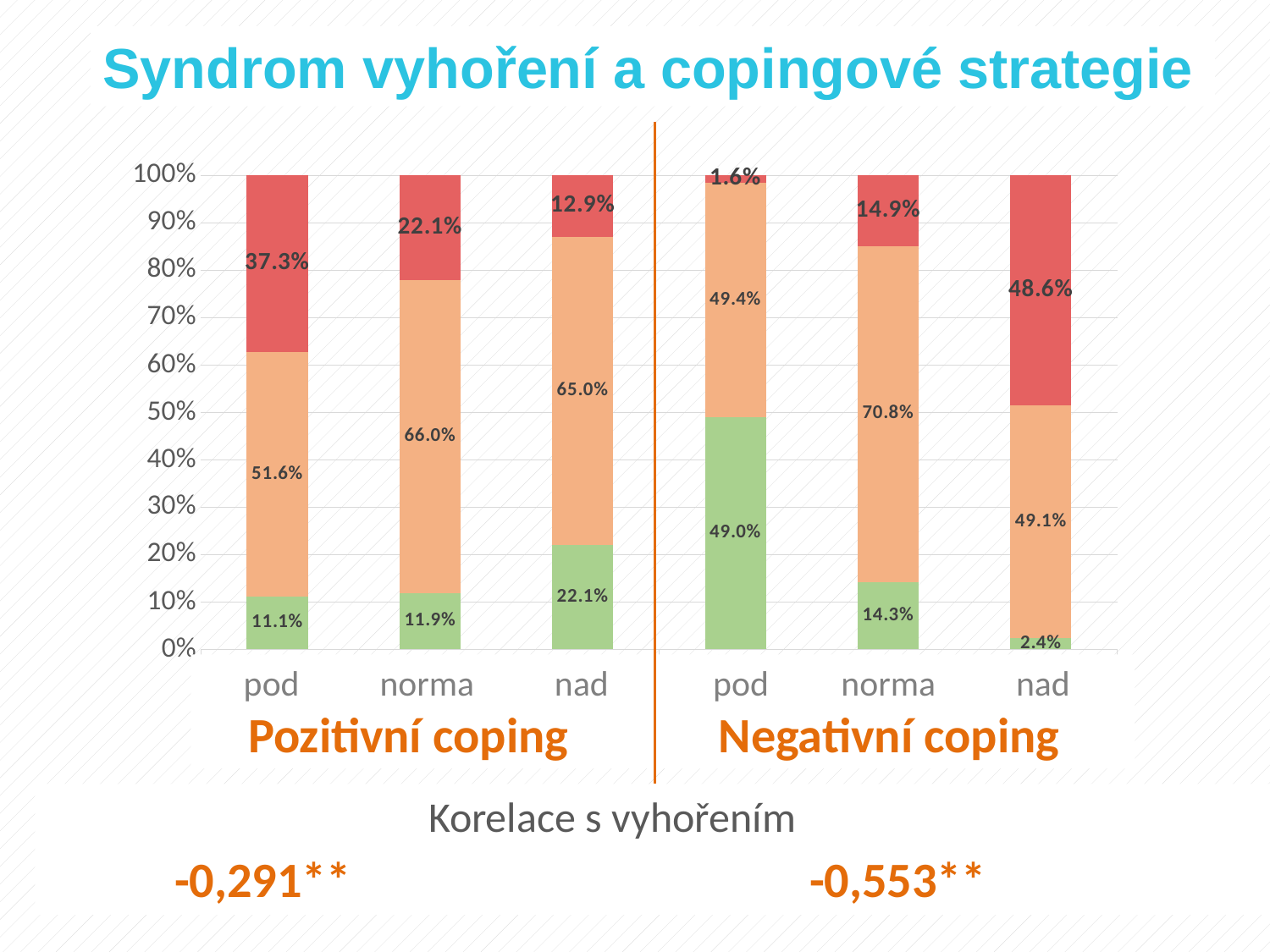
What is the value of the orange (middle) segment for 'nad' under Pozitivní coping? 65.0% How many bars are plotted in the chart? 6 What is the title of the slide? Syndrom vyhoření a copingové strategie What is the value of the red (top) segment for 'nad' under Negativní coping? 48.6% What correlation with burnout is shown for Negativní coping? -0,553** What is the difference between the red segment for 'pod' and the red segment for 'nad' under Pozitivní coping? 24.4 percentage points What is the value of the green (bottom) segment for 'pod' under Pozitivní coping? 11.1% What kind of chart is shown on the slide? Stacked bar chart What is the value of the orange (middle) segment for 'norma' under Negativní coping? 70.8% Which bar has the smallest red (top) segment? pod under Negativní coping (1.6%) Which is larger: the green segment for 'nad' under Pozitivní coping or the green segment for 'norma' under Negativní coping? nad under Pozitivní coping (22.1%) Which bar has the largest green (bottom) segment? pod under Negativní coping (49.0%)